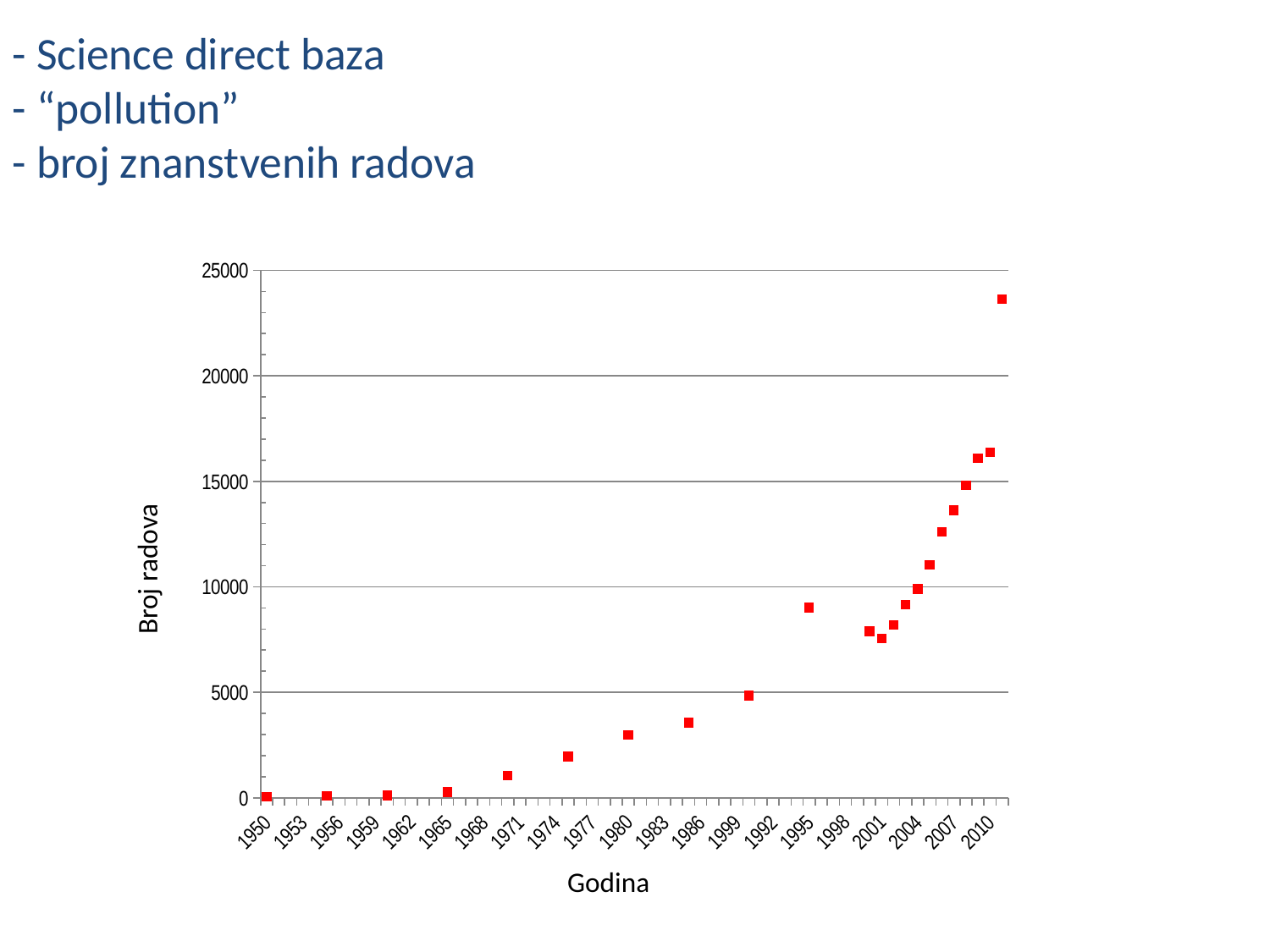
What kind of chart is shown on the slide? scatter chart What is the title of the vertical axis? Broj radova Is the value for 2010 greater or less than 15000? greater Which is larger, the value for 1995 or the value for 2001? 1995 What is the title of the horizontal axis? Godina Which is larger, the value for 1985 or the value for 1975? 1985 Is the value for 2007 greater or less than 10000? greater Is the value for 1995 greater or less than 10000? less Do the values generally rise or fall as the years increase along the x axis? rise